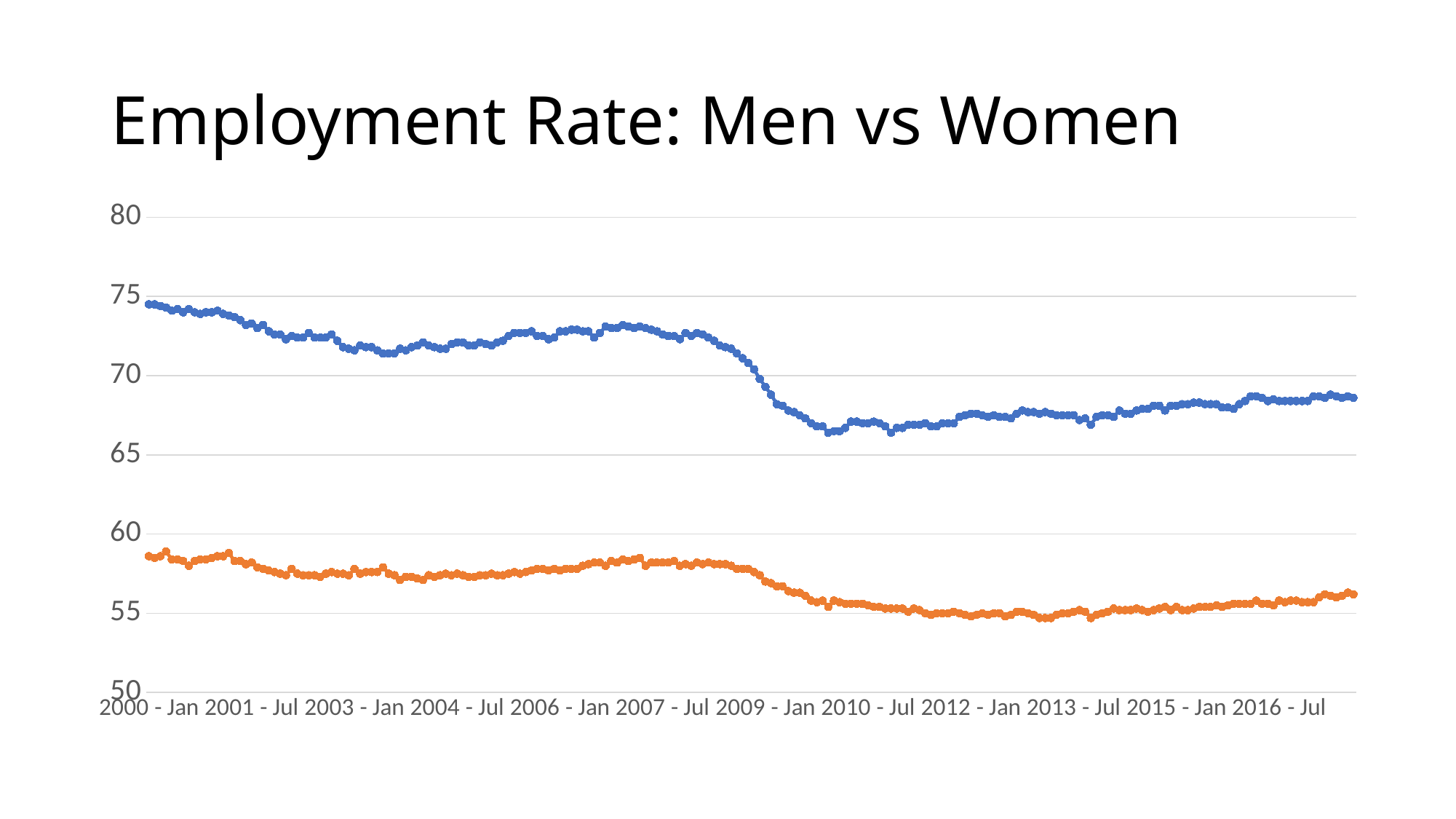
How many lines are plotted on the chart? 2 How many tick labels are shown on the x axis? 12 Is the value of the blue line at 2010 - Jul greater or less than 70? less Is the value of the blue line at 2000 - Jan greater or less than 70? greater Is the value of the orange line at 2013 - Jul greater or less than 60? less Does the blue line overall rise or fall from 2000 - Jan to 2016 - Jul? fall Which line is higher throughout the chart, the blue line or the orange line? the blue line What is the title of the chart? Employment Rate: Men vs Women What kind of chart is shown on the slide? line chart What is the highest value shown on the y axis? 80